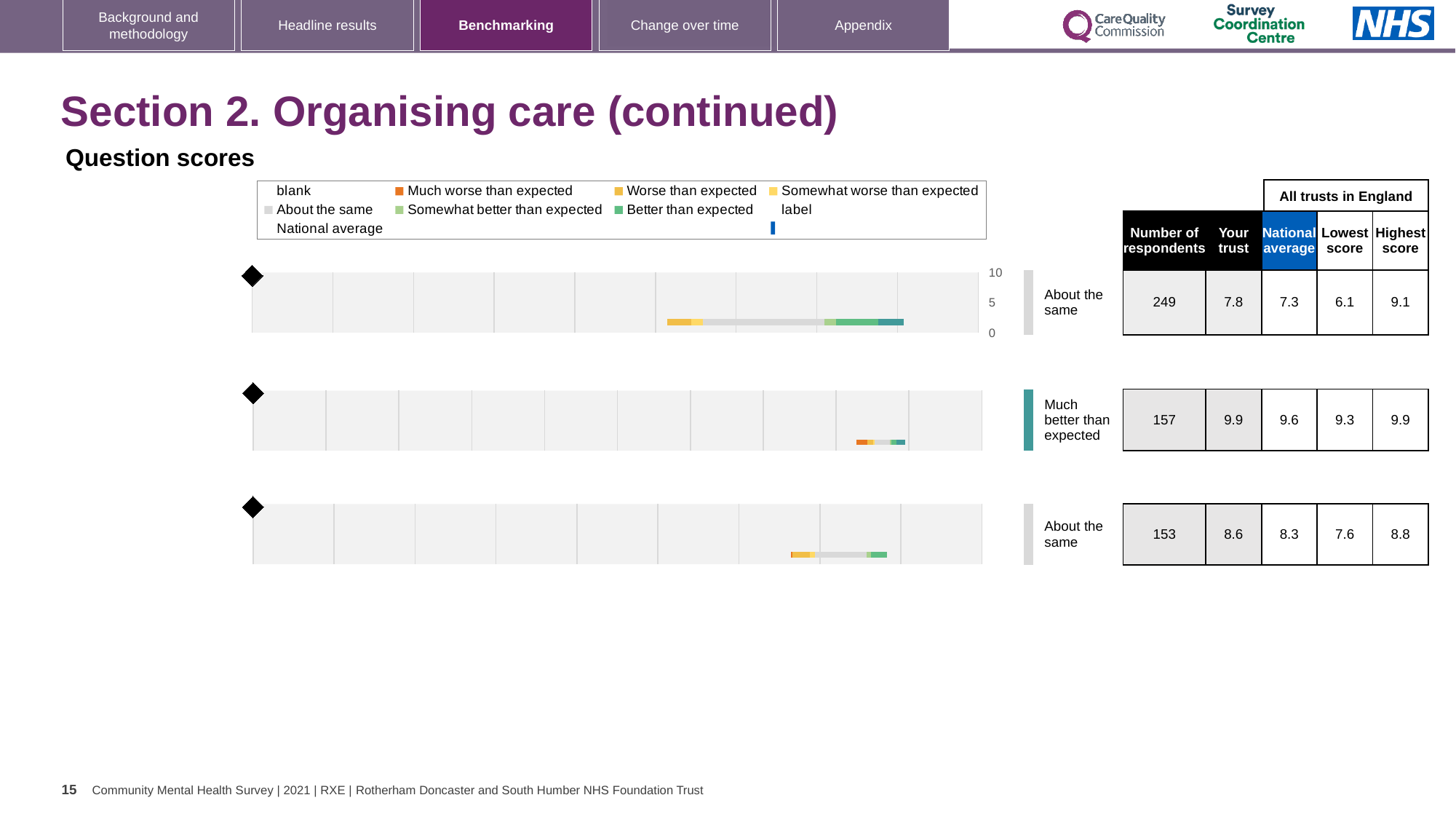
For the bottom chart, which is larger: the 'Your trust' score or the national average? Your trust What is the maximum value shown on the score axis of the top chart? 10 How many benchmarking charts are shown on the slide? 3 For the top chart, what is the 'Your trust' score? 7.8 Which chart has the highest 'Your trust' score? the middle chart (9.9) For the bottom chart, what is the highest score among all trusts in England? 8.8 For the middle chart, how many respondents are there? 157 What benchmark category is the middle chart labelled with? Much better than expected For the top chart, what is the national average score? 7.3 What kind of chart is used on this slide to show the question scores? bar chart For the top chart, what is the difference between the 'Your trust' score and the national average? 0.5 In the legend, which colour represents 'Much worse than expected'? orange